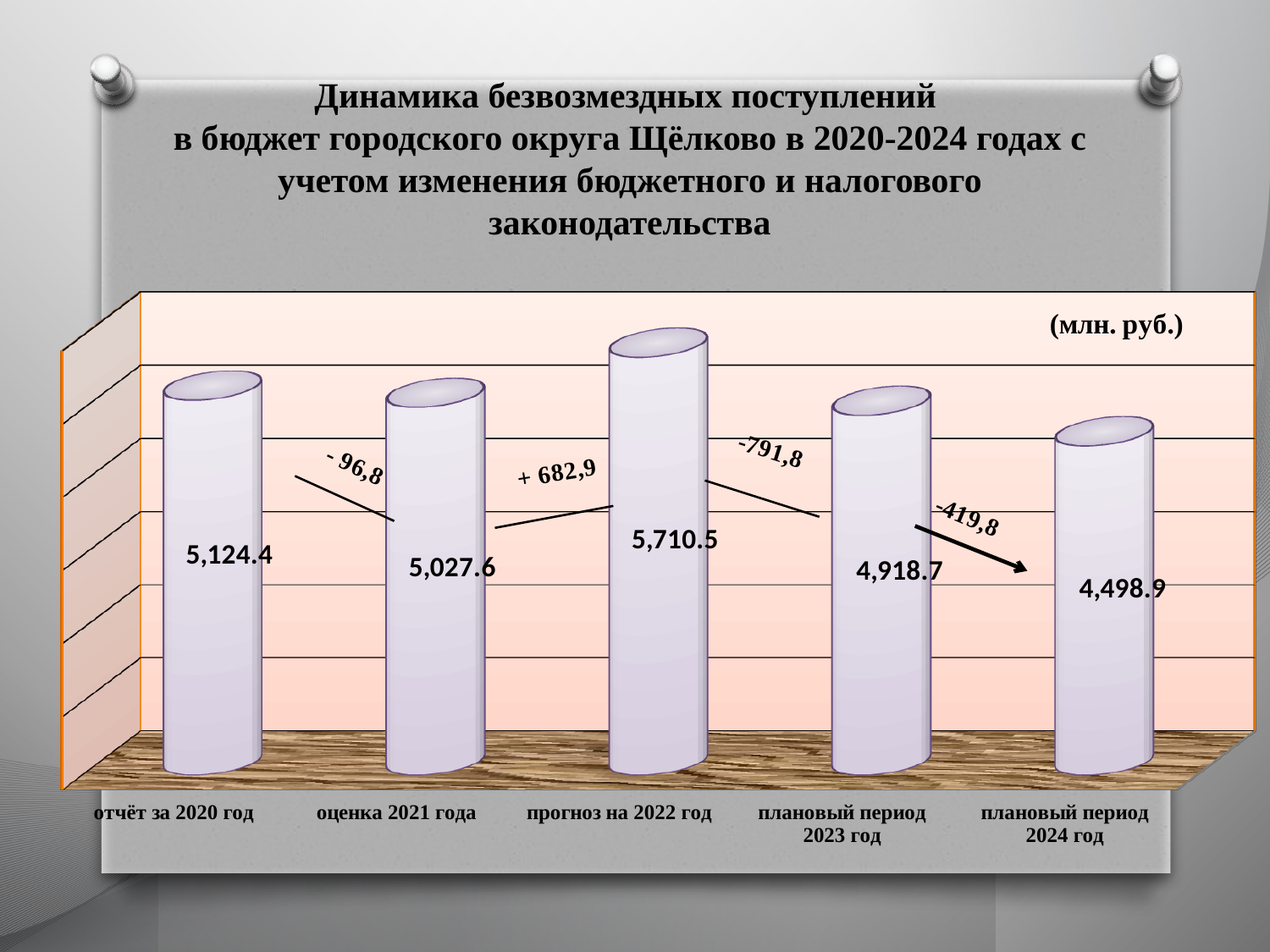
Which category has the highest value? прогноз на 2022 год Which category has the lowest value? плановый период 2024 год What kind of chart is shown on the slide? bar chart What is the value for 'оценка 2021 года'? 5,027.6 How many categories are shown on the chart? 5 What is the value for 'отчёт за 2020 год'? 5,124.4 What is the difference between the values for 'прогноз на 2022 год' and 'плановый период 2023 год'? 791.8 What is the value for 'прогноз на 2022 год'? 5,710.5 Which is larger: the value for 'плановый период 2023 год' or 'плановый период 2024 год'? плановый период 2023 год In what units are the values on the chart given? млн. руб. What is the value for 'плановый период 2024 год'? 4,498.9 What is the difference between the values for 'отчёт за 2020 год' and 'оценка 2021 года'? 96.8